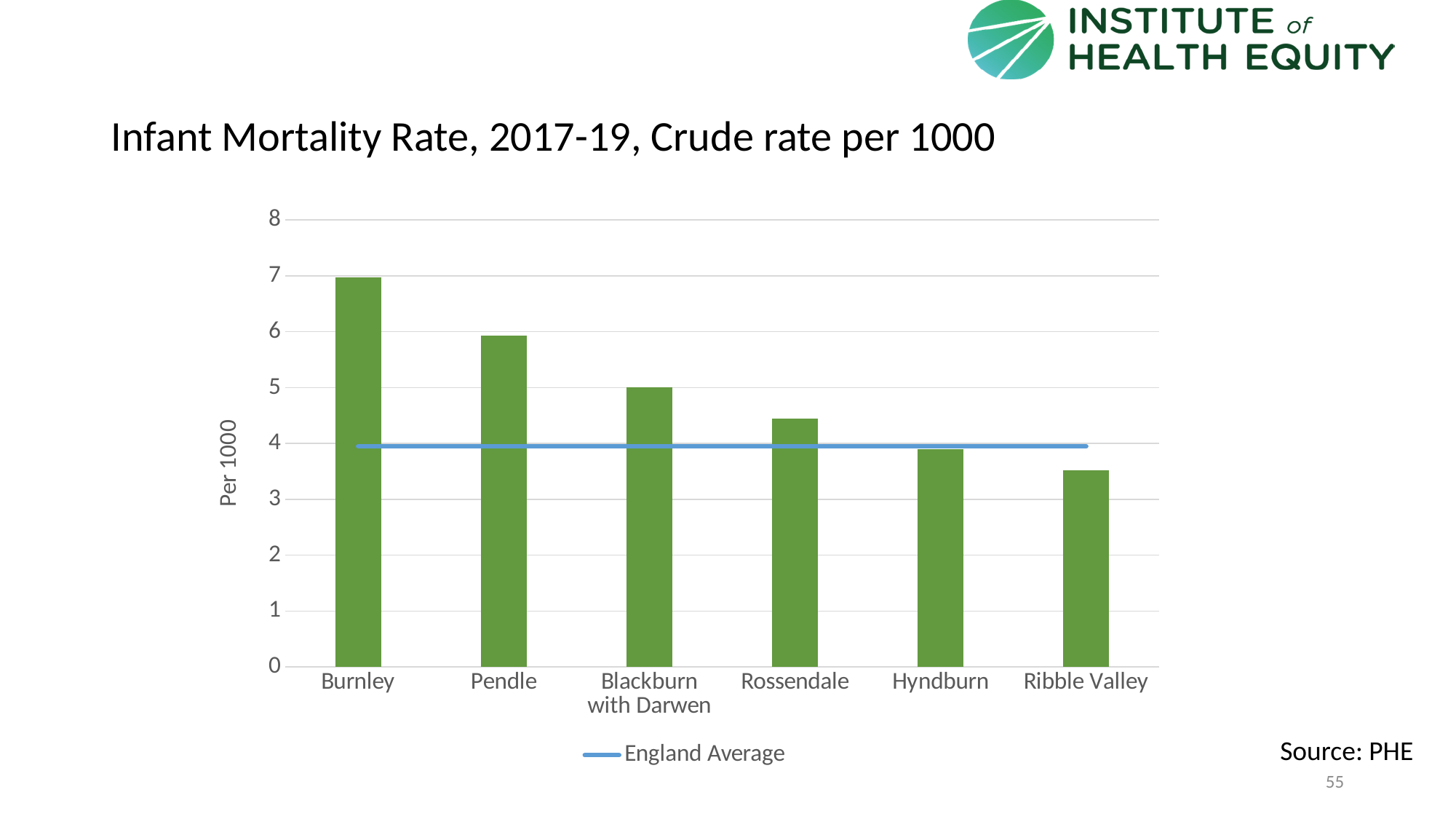
Is the value for Rossendale greater or less than 4? greater Is the value for Pendle greater or less than 5? greater What kind of chart is shown on the slide? bar chart How many local authority areas are shown on the x axis of the chart? 6 Is the value for Ribble Valley greater or less than 4? less Which area has the highest infant mortality rate in the chart? Burnley What entry does the chart legend list? England Average What is the label on the vertical axis of the chart? Per 1000 Which area has the lowest infant mortality rate in the chart? Ribble Valley Do the bar values rise or fall moving from left to right along the x axis? fall Which has a higher infant mortality rate, Burnley or Pendle? Burnley